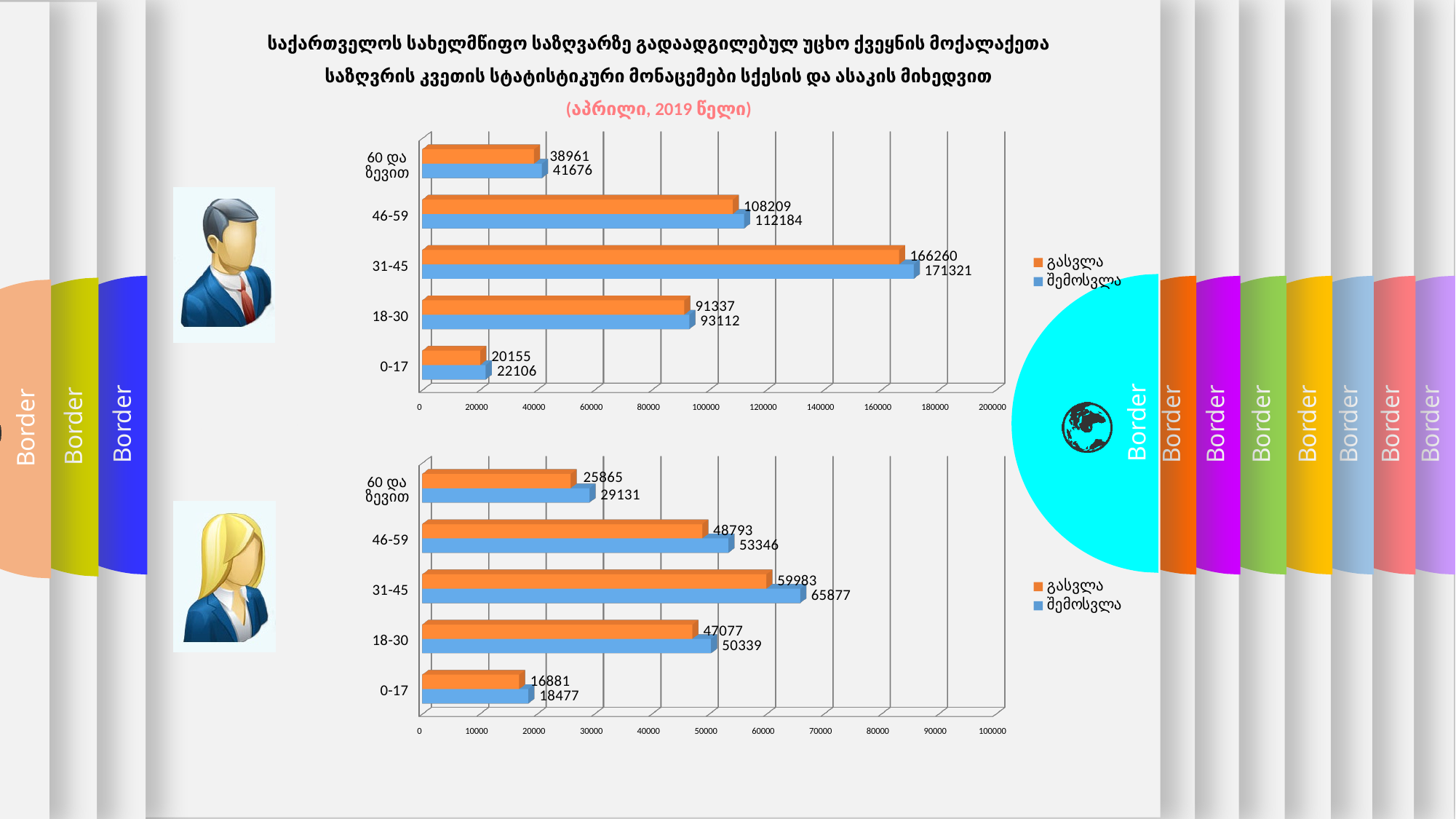
In the top chart, which age group has the highest გასვლა value? 31-45 How many age groups are shown in the bottom chart? 5 In the top chart, which is larger for the 18-30 age group: გასვლა or შემოსვლა? შემოსვლა In the bottom chart, what is the value of გასვლა for the 18-30 age group? 47077 In the bottom chart, what is the value of შემოსვლა for the 46-59 age group? 53346 What type of chart is the bottom chart? Bar chart In the bottom chart, which age group has the lowest შემოსვლა value? 0-17 In the top chart, what is the difference between შემოსვლა and გასვლა for the 46-59 age group? 3975 In the bottom chart, what is the difference between შემოსვლა and გასვლა for the 31-45 age group? 5894 In the top chart, what is the value of გასვლა for the 0-17 age group? 20155 How many series does the legend of the top chart list? 2 In the top chart, what is the value of შემოსვლა for the 31-45 age group? 171321